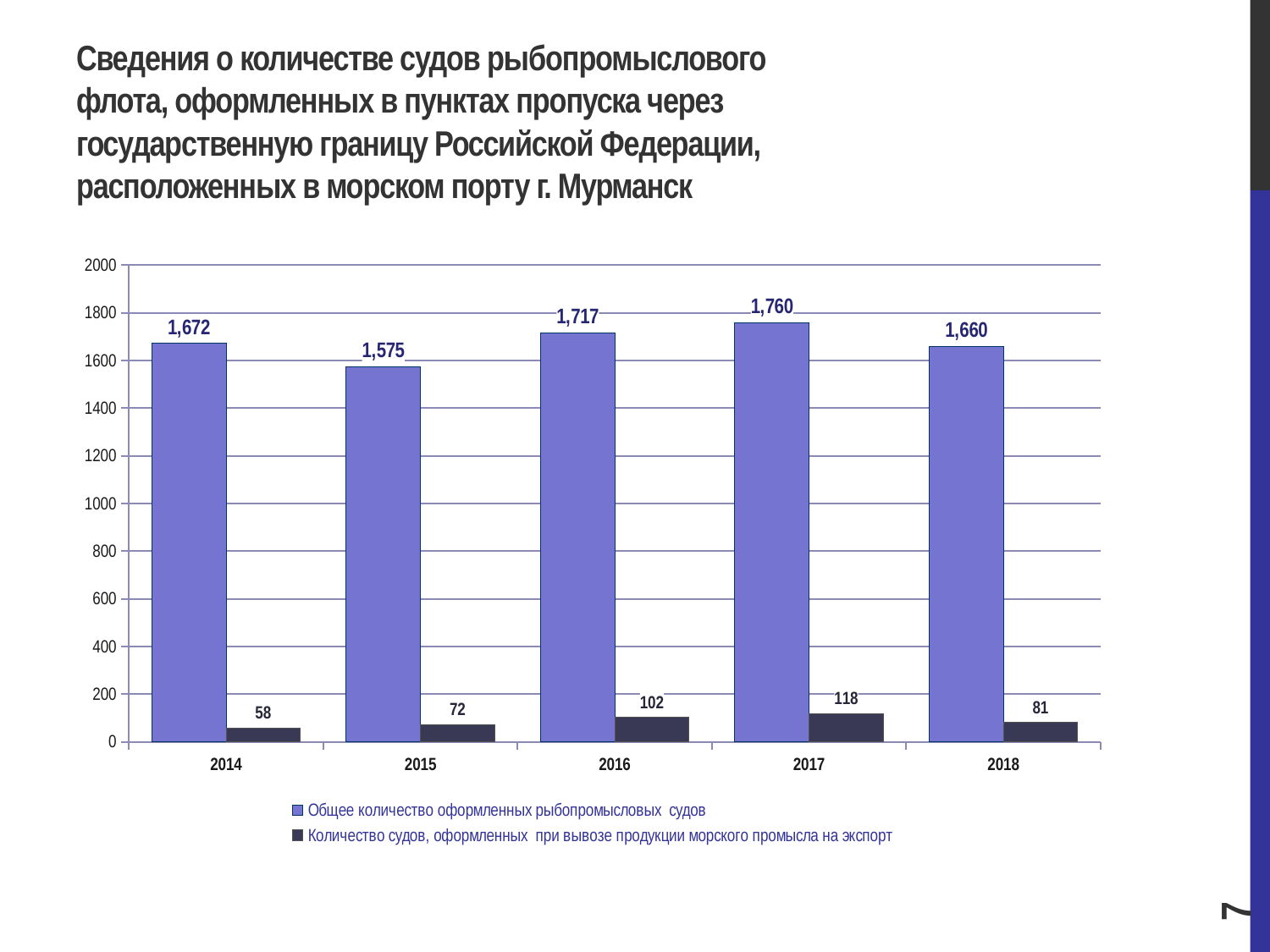
What kind of chart is shown on the slide? Bar chart Which is larger: 'Общее количество оформленных рыбопромысловых судов' in 2014 or in 2018? 2014 How many series does the legend list? 2 What is the value of 'Количество судов, оформленных при вывозе продукции морского промысла на экспорт' for 2017? 118 What is the value of 'Общее количество оформленных рыбопромысловых судов' for 2016? 1,717 In which year is 'Общее количество оформленных рыбопромысловых судов' highest? 2017 In which year is 'Общее количество оформленных рыбопромысловых судов' lowest? 2015 What is the value of 'Количество судов, оформленных при вывозе продукции морского промысла на экспорт' for 2014? 58 In which year is 'Количество судов, оформленных при вывозе продукции морского промысла на экспорт' lowest? 2014 What is the difference between the 'Общее количество оформленных рыбопромысловых судов' values for 2017 and 2018? 100 How many years are shown on the x axis? 5 What is the difference between the export-vessel values for 2016 and 2015? 30